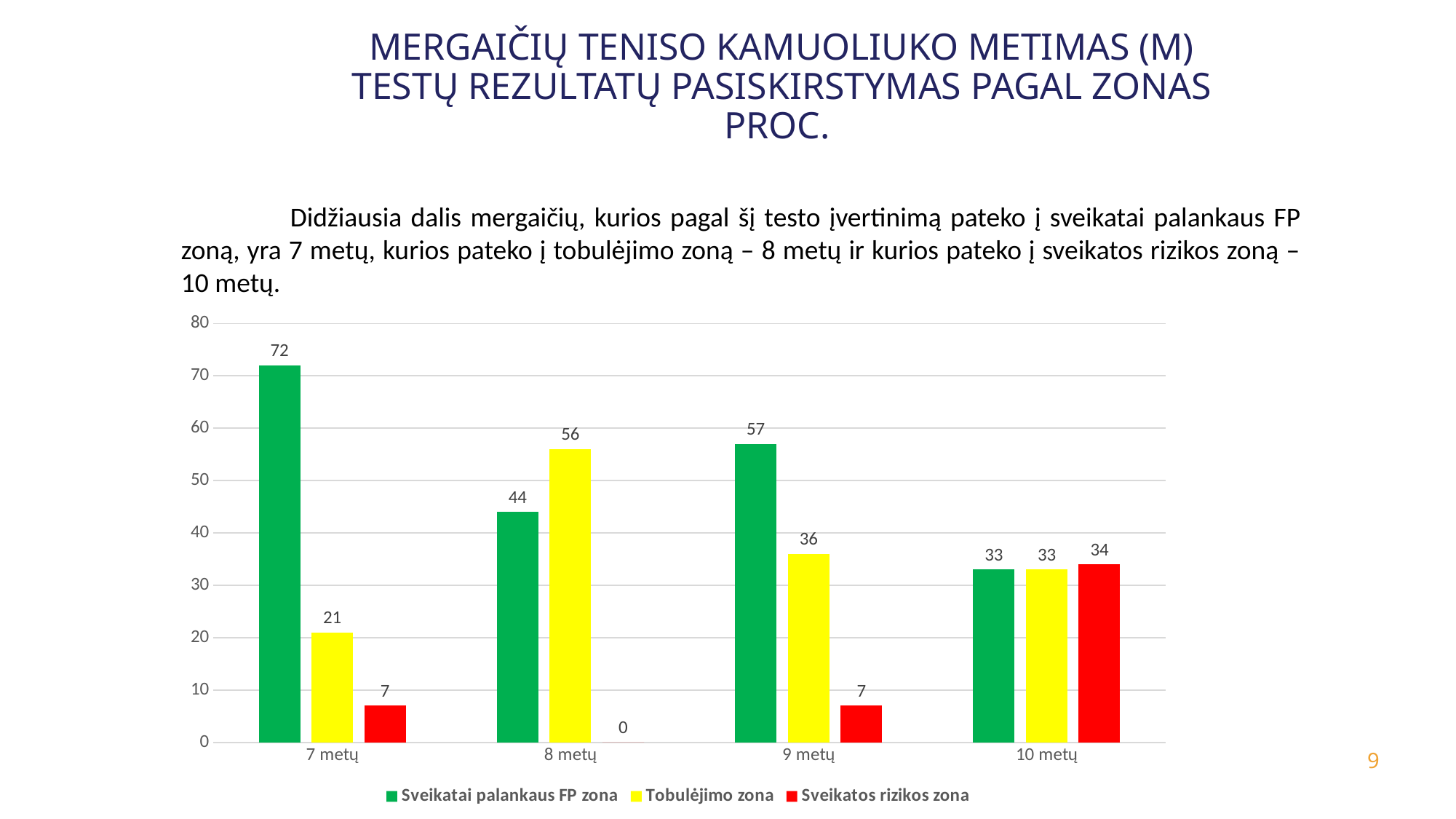
What is the value for Sveikatos rizikos zona at 8 metų? 0 What is the difference between Sveikatai palankaus FP zona and Tobulėjimo zona at 9 metų? 21 How many series does the legend list? 3 Which age group has the highest value for Sveikatai palankaus FP zona? 7 metų What is the value for Sveikatai palankaus FP zona at 7 metų? 72 What is the value for Tobulėjimo zona at 8 metų? 56 How many age groups are shown on the x axis? 4 Which age group has the lowest value for Tobulėjimo zona? 7 metų Which is larger at 8 metų: Sveikatai palankaus FP zona or Tobulėjimo zona? Tobulėjimo zona What is the value for Sveikatos rizikos zona at 10 metų? 34 What kind of chart is shown on the slide? Bar chart